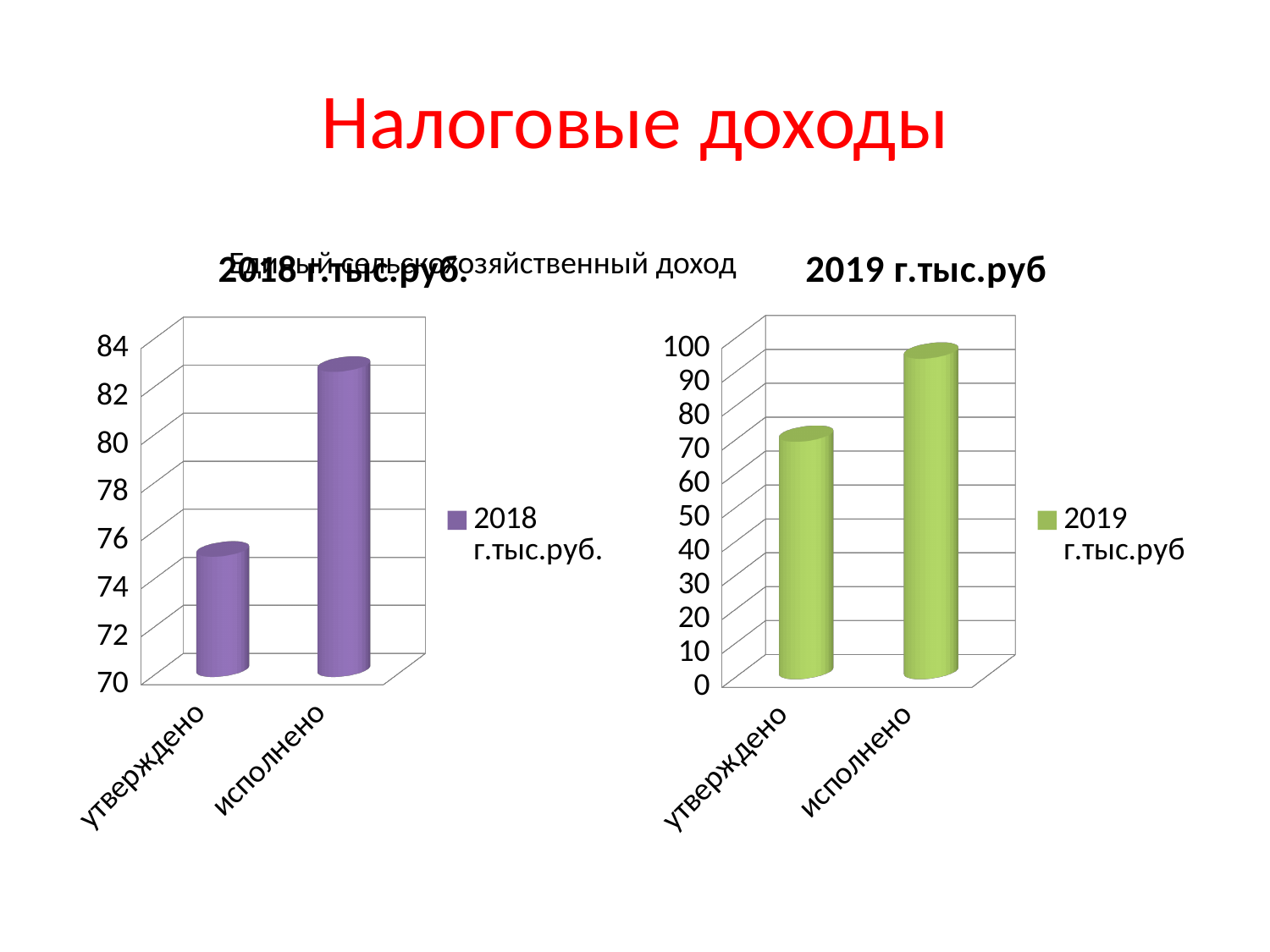
In the right chart (2019 г.тыс.руб), is the value for утверждено greater or less than 60? greater In the left chart (2018 г.тыс.руб.), is the value for утверждено greater or less than 80? less How many categories are shown on the x axis of the left chart (2018 г.тыс.руб.)? 2 In the left chart (2018 г.тыс.руб.), which category has the lower value? утверждено In the right chart (2019 г.тыс.руб), which category has the higher value? исполнено In the left chart (2018 г.тыс.руб.), which category has the higher value? исполнено In the left chart (2018 г.тыс.руб.), is the value for исполнено greater or less than 80? greater What kind of chart is the left chart titled "2018 г.тыс.руб."? bar chart In the right chart (2019 г.тыс.руб), do the values rise or fall from утверждено to исполнено? rise What is the legend entry of the left chart (2018 г.тыс.руб.)? 2018 г.тыс.руб. How many series does the legend of the right chart (2019 г.тыс.руб) list? 1